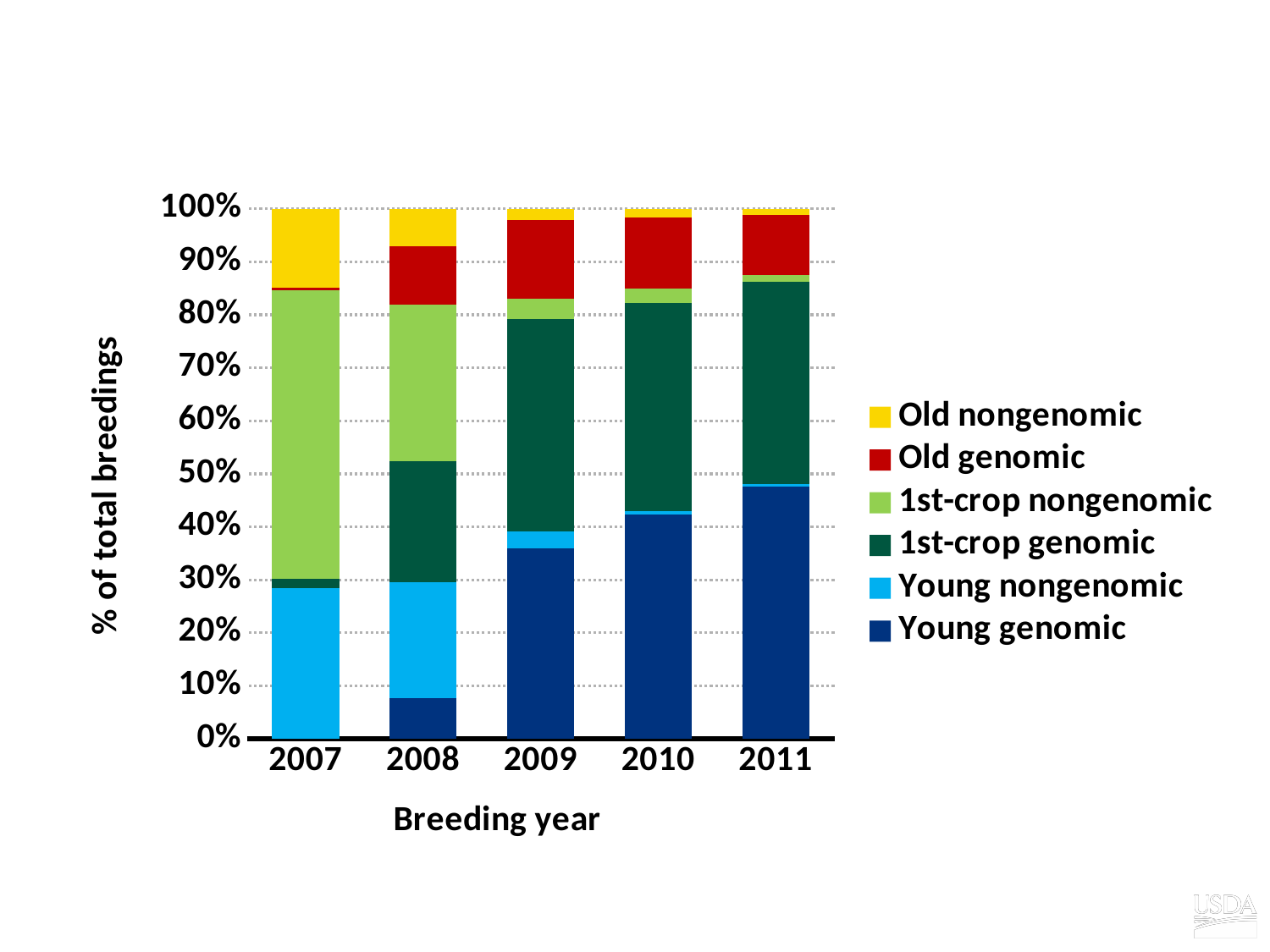
What is the title of the y axis? % of total breedings What is the title of the x axis? Breeding year Is the Young nongenomic share in 2007 greater or less than 20%? greater How many series does the legend list? 6 What kind of chart is shown on the slide? Stacked bar chart Which breeding year has the largest Young genomic share? 2011 Which year has the larger 1st-crop nongenomic share, 2007 or 2011? 2007 Is the Young genomic share in 2011 greater or less than 40%? greater How many breeding years are shown on the x axis? 5 Does the Young genomic share rise or fall from 2008 to 2011? rise Which breeding year has the largest Old nongenomic share? 2007 Is the Young genomic share in 2008 greater or less than 10%? less